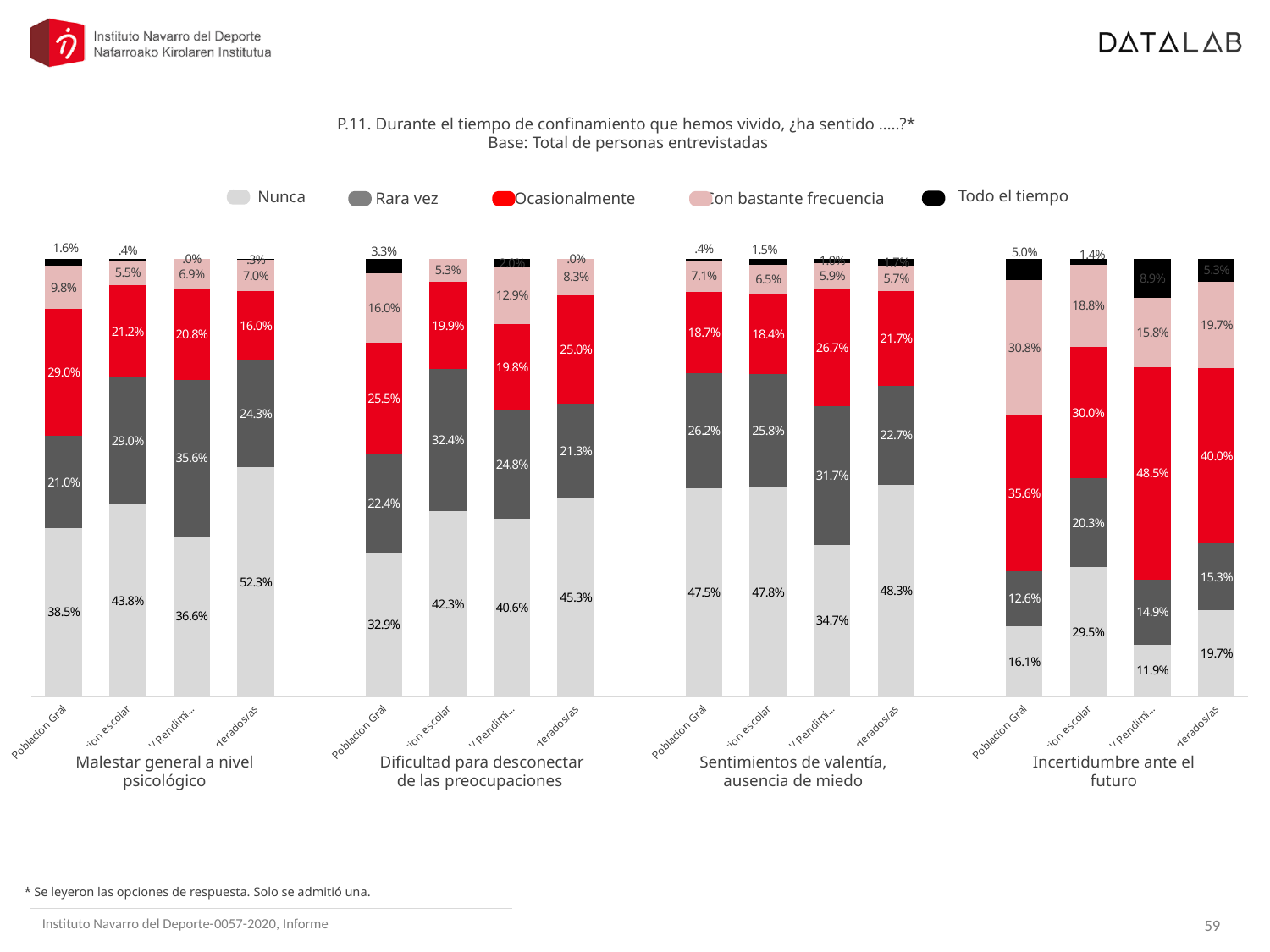
Across the four groups, in which group is the 'Nunca' value for Poblacion Gral the highest? Sentimientos de valentía, ausencia de miedo How many question groups (panels) are shown along the x axis of the chart? 4 Which legend entry is shown in red? Ocasionalmente What type of chart is shown on the slide? Stacked bar chart How many series does the legend list? 5 For Poblacion Gral, what is the difference between the 'Nunca' value in the 'Malestar general a nivel psicológico' group and the 'Nunca' value in the 'Dificultad para desconectar de las preocupaciones' group? 5.6 percentage points In the 'Incertidumbre ante el futuro' group, what is the 'Con bastante frecuencia' value for Poblacion Gral? 30.8% For Poblacion Gral, is the 'Ocasionalmente' value larger in the 'Incertidumbre ante el futuro' group or in the 'Malestar general a nivel psicológico' group? Incertidumbre ante el futuro In the 'Dificultad para desconectar de las preocupaciones' group, what is the 'Ocasionalmente' value for Poblacion Gral? 25.5% In the 'Malestar general a nivel psicológico' group, what is the 'Nunca' value for Poblacion Gral? 38.5% In the 'Sentimientos de valentía, ausencia de miedo' group, what is the 'Rara vez' value for Poblacion Gral? 26.2% In the 'Incertidumbre ante el futuro' group, what is the 'Todo el tiempo' value for Poblacion Gral? 5.0%